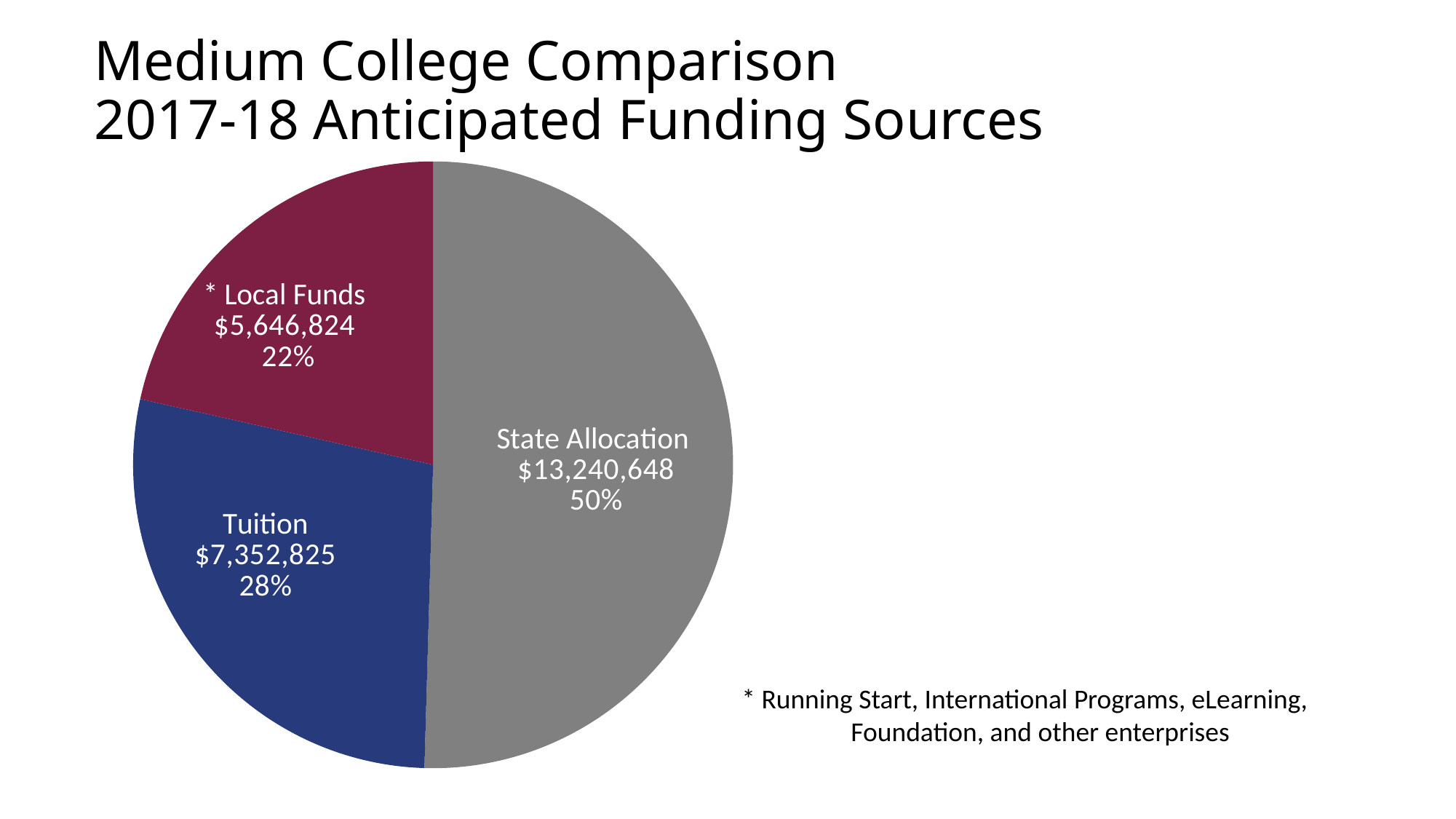
What share of the pie does Local Funds represent? 22% What is the difference in dollars between State Allocation and Tuition? $5,887,823 Which is larger, Tuition or Local Funds? Tuition How many slices does the pie chart have? 3 What is the dollar value of the Tuition slice? $7,352,825 Which funding source is the largest slice of the pie? State Allocation What share of the pie does Tuition represent? 28% Which funding source is the smallest slice of the pie? Local Funds What is the dollar value of the State Allocation slice? $13,240,648 What is the dollar value of the Local Funds slice? $5,646,824 What colour is the State Allocation slice? Grey What kind of chart is shown on the slide? Pie chart